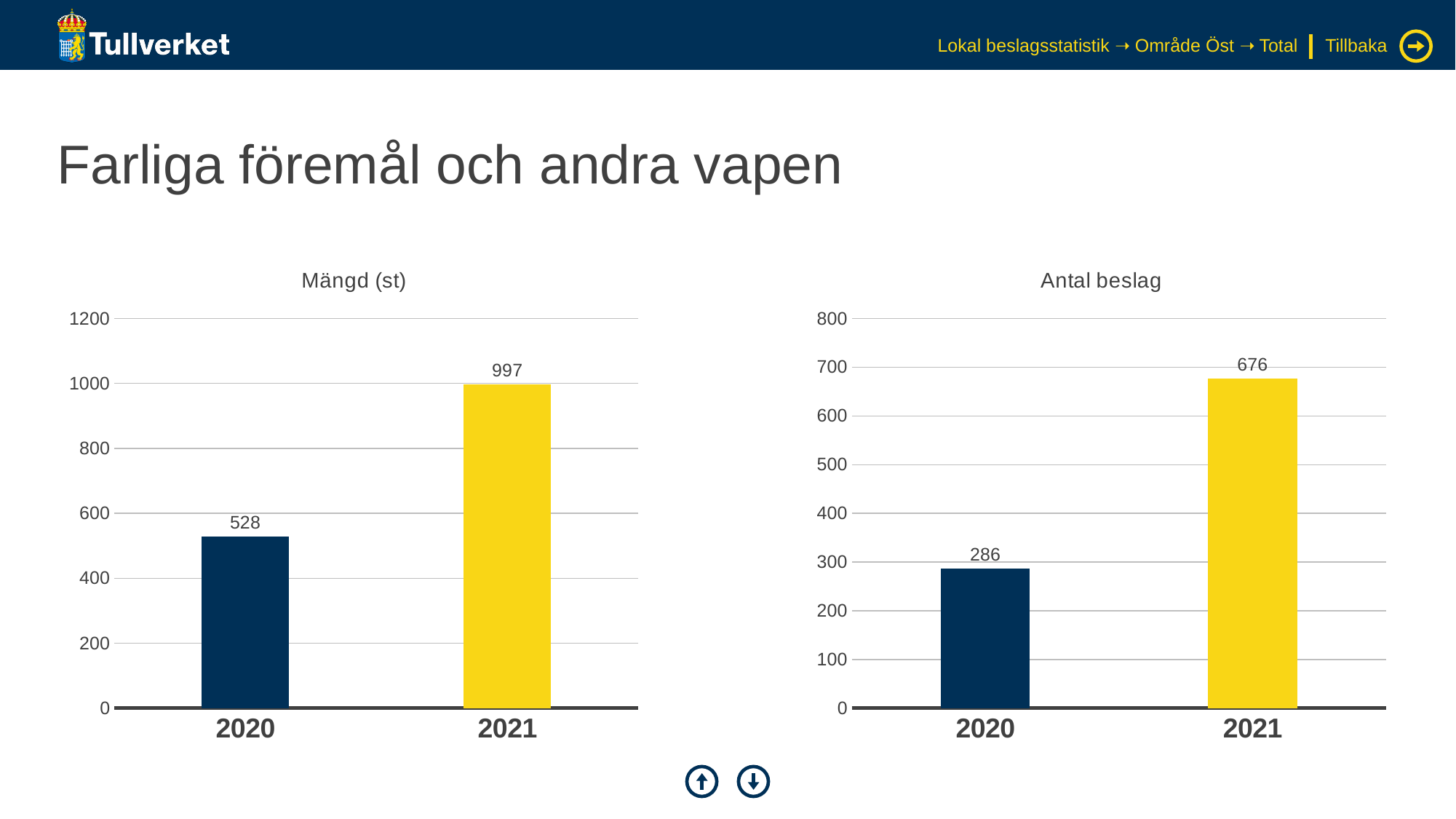
In the 'Antal beslag' chart, what is the value for 2021? 676 In the 'Antal beslag' chart, which year has the lowest value? 2020 In the 'Mängd (st)' chart, what is the difference between the 2021 and 2020 values? 469 In the 'Antal beslag' chart, what is the difference between the 2021 and 2020 values? 390 What kind of chart is the 'Antal beslag' chart? bar chart In the 'Mängd (st)' chart, do the values rise or fall from 2020 to 2021? rise In the 'Mängd (st)' chart, how many years are shown on the x axis? 2 In the 'Antal beslag' chart, is the value for 2020 greater or less than 300? less In the 'Mängd (st)' chart, what is the value for 2020? 528 In the 'Mängd (st)' chart, what is the value for 2021? 997 In the 'Mängd (st)' chart, which year has the highest value? 2021 In the 'Antal beslag' chart, what is the value for 2020? 286